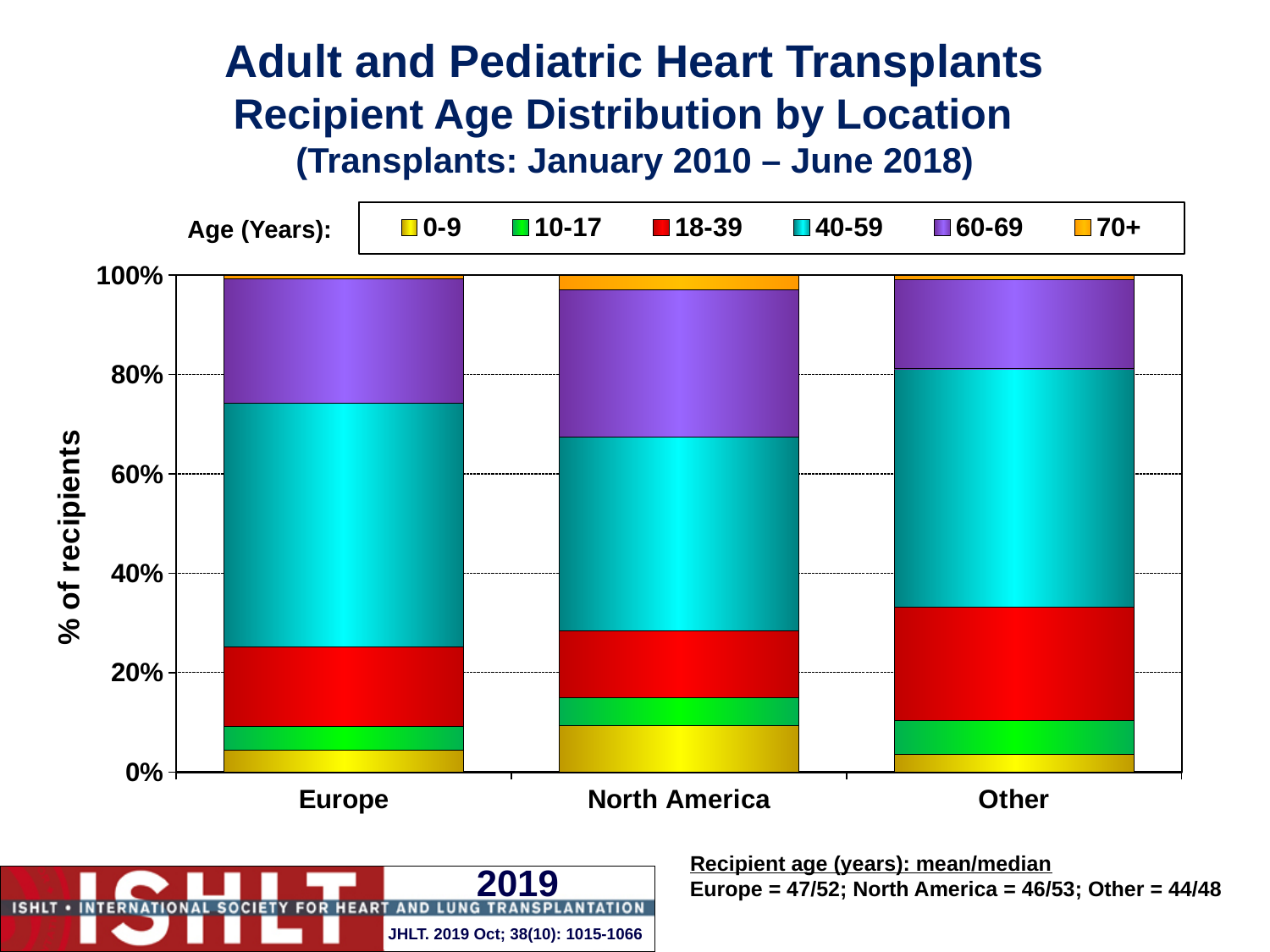
How many age groups does the legend list? 6 Which location has the largest 0-9 age segment? North America Which location has the largest 18-39 age segment? Other Which location has the smallest 60-69 age segment? Other Is the top of the 40-59 segment for Europe greater or less than 60%? greater What kind of chart is shown on the slide? Stacked bar chart Which age group is shown in purple in the legend? 60-69 Is the 60-69 segment larger for North America or for Other? North America Which location has the smallest 40-59 age segment? North America What is the label on the y axis? % of recipients How many locations (categories) are shown on the x axis? 3 Is the top of the 18-39 segment for Other greater or less than 40%? less